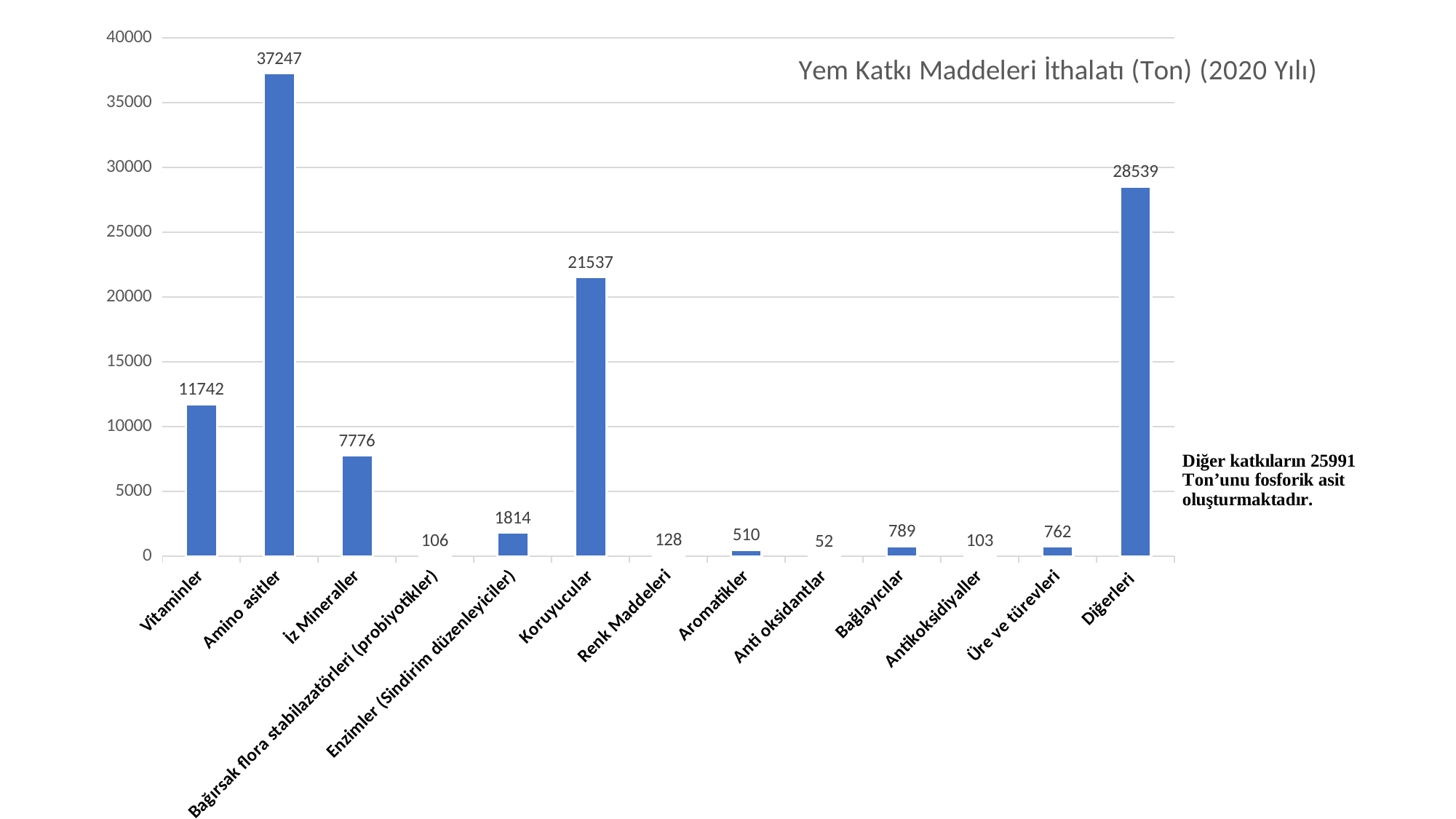
What kind of chart is shown on the slide? bar chart What is the value for Amino asitler? 37247 Is the value for Vitaminler greater or less than 10000? greater What is the value for Enzimler (Sindirim düzenleyiciler)? 1814 Which category has the highest value? Amino asitler Which is larger, the value for Vitaminler or the value for İz Mineraller? Vitaminler What is the difference between the values for Diğerleri and Koruyucular? 7002 What is the difference between the values for Vitaminler and İz Mineraller? 3966 What is the value for Koruyucular? 21537 What is the value for Üre ve türevleri? 762 Which category has the lowest value? Anti oksidantlar How many categories are shown on the x axis? 13